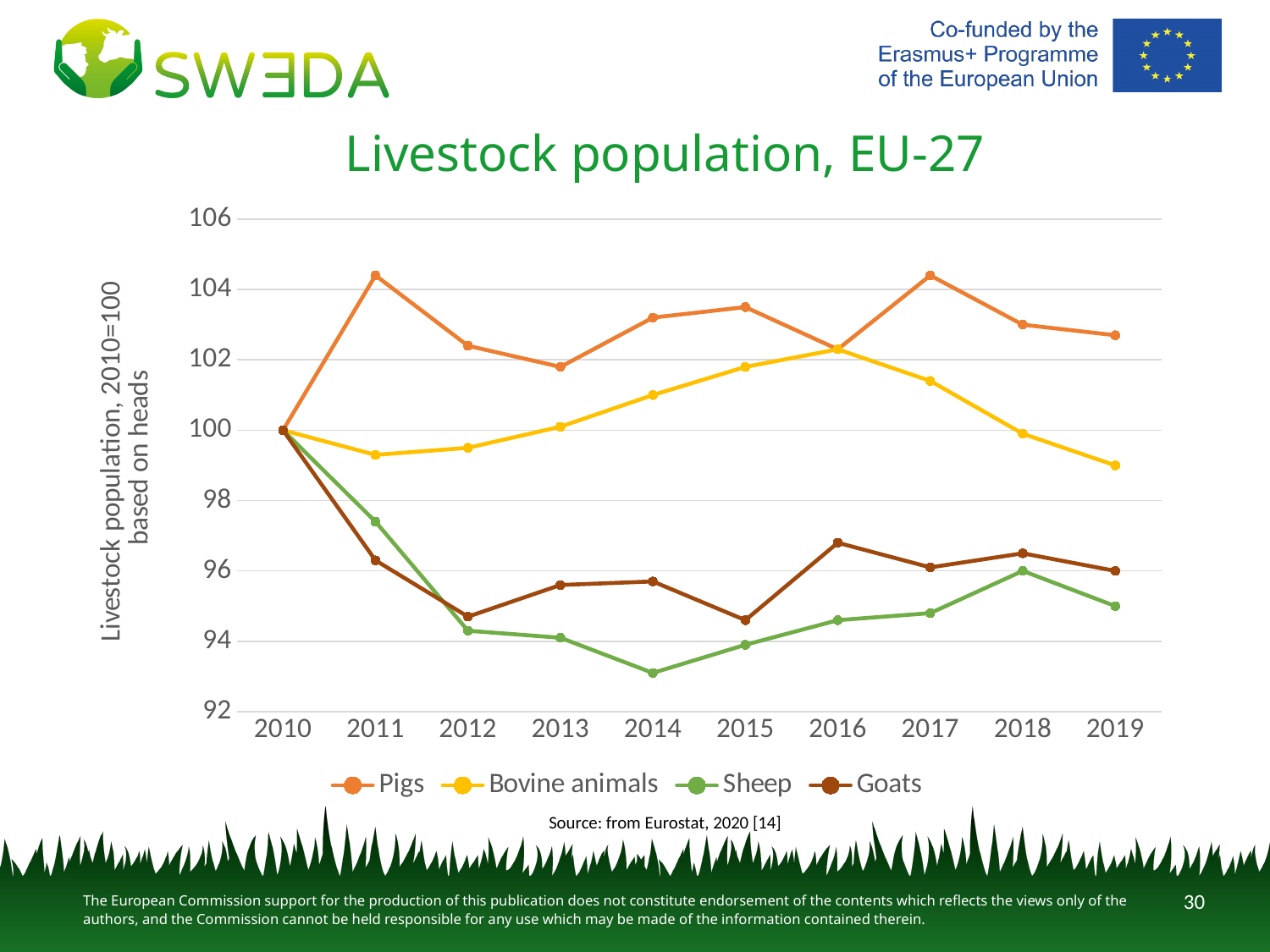
Do the values for Bovine animals rise or fall from 2016 to 2019? fall Is the value for Pigs in 2011 greater or less than 104? greater How many years are plotted along the x axis? 10 In 2015, which is larger, the value for Pigs or the value for Sheep? Pigs How many series does the legend list? 4 Which series has the highest value in 2019? Pigs What kind of chart is shown on the slide? line chart Is the value for Goats in 2016 greater or less than 96? greater Is the value for Bovine animals in 2019 greater or less than 100? less What is the value for Pigs in 2010? 100 Which series has the lowest value in 2014? Sheep